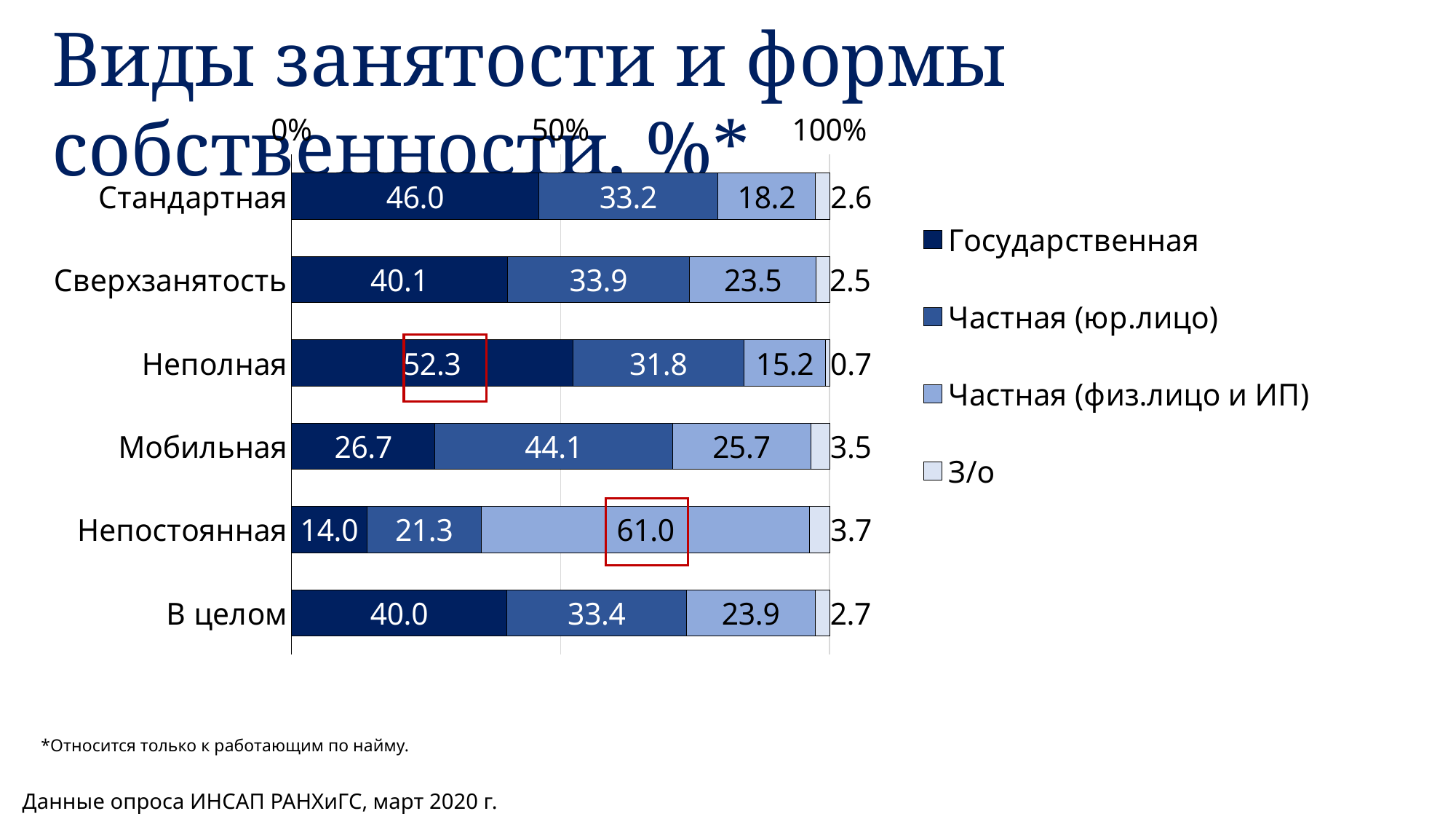
Which is larger: Частная (физ.лицо и ИП) for Мобильная or for Сверхзанятость? Мобильная What is the value of З/о for Сверхзанятость? 2.5 What type of chart is shown on the slide? Stacked bar chart How many series does the legend list? 4 What is the value of Частная (юр.лицо) for Мобильная? 44.1 Which category has the highest value for Государственная? Неполная What is the value of Государственная for Неполная? 52.3 What is the total of the stacked bar for Непостоянная? 100.0 How many employment categories are plotted on the chart? 6 What is the difference between the Государственная values for Стандартная and В целом? 6.0 What is the value of Частная (физ.лицо и ИП) for Непостоянная? 61.0 Which category has the lowest value for Государственная? Непостоянная